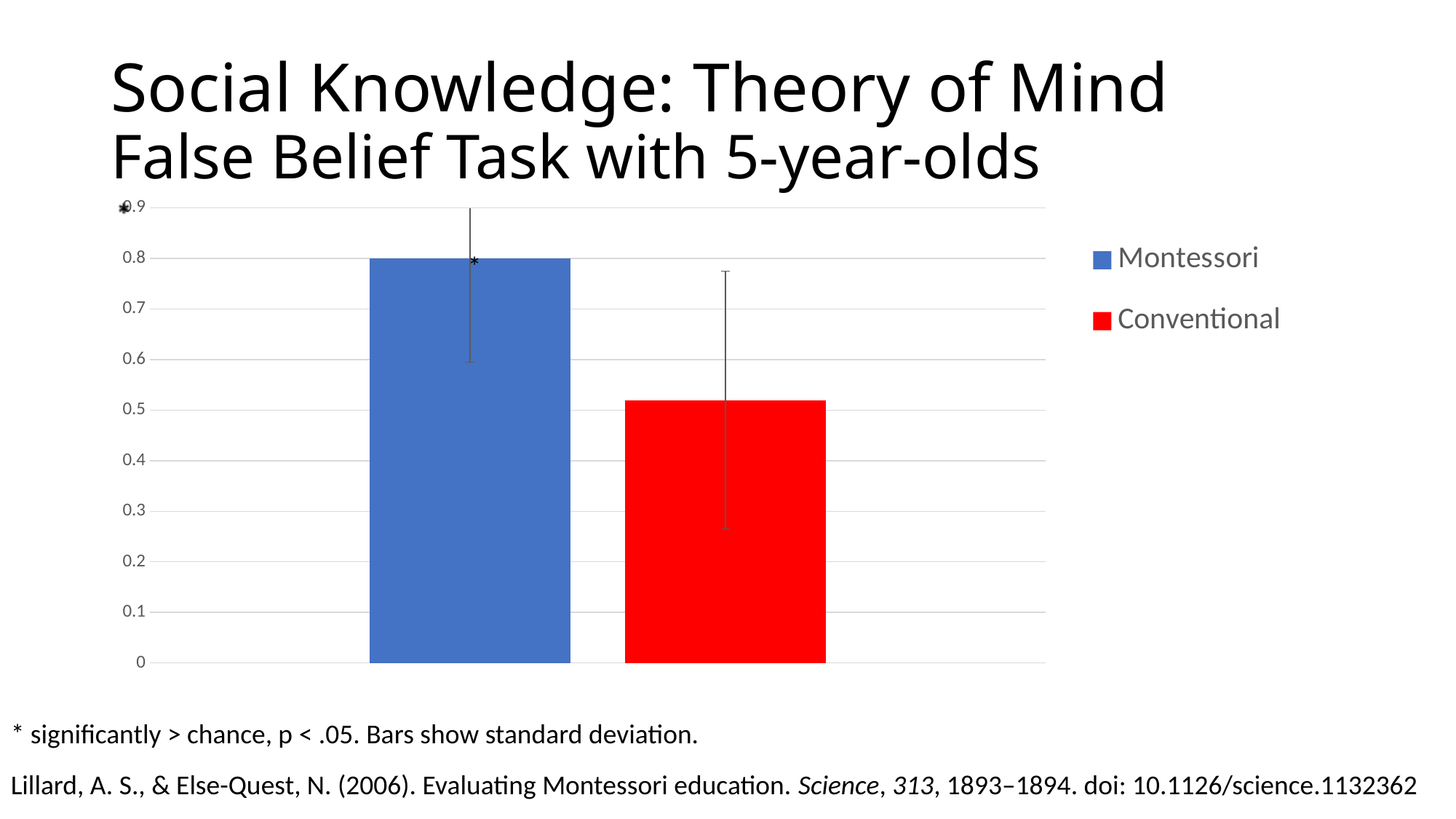
Is the value for Conventional greater or less than 0.6? less Is the value for Conventional greater or less than 0.4? greater Which group has the highest bar? Montessori Which group has the lowest bar? Conventional What kind of chart is shown on the slide? bar chart How many series does the legend list? 2 Which is larger, the value for Montessori or the value for Conventional? Montessori Which series is shown in blue according to the legend? Montessori What colour is the Conventional bar? red How many bars are plotted in the chart? 2 What is the value for Montessori? 0.8 Is the value for Montessori greater or less than 0.7? greater